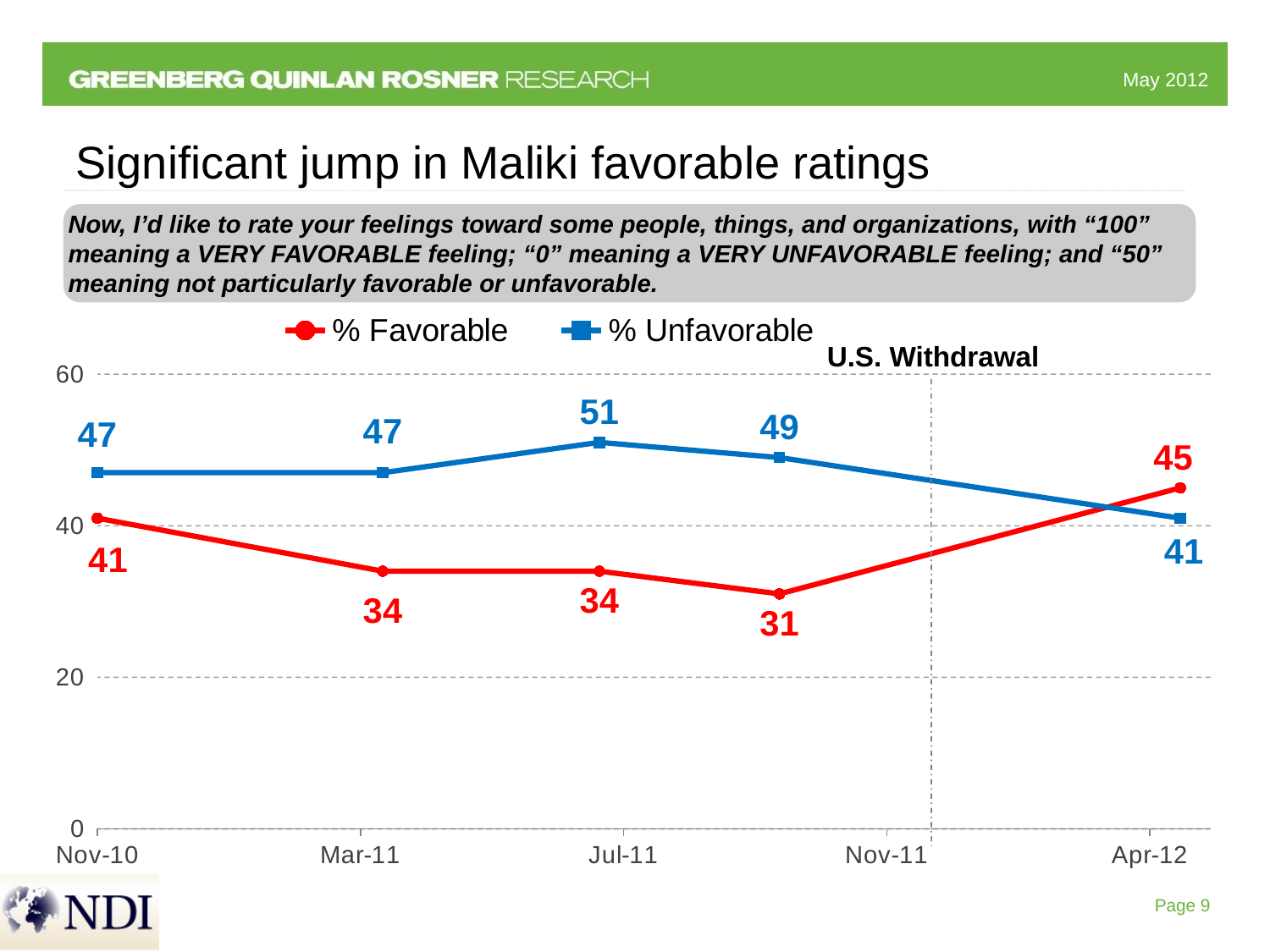
What is the % Favorable value at Mar-11? 34 What is the highest value reached by the % Unfavorable series? 51 At Apr-12, how much higher is % Favorable than % Unfavorable? 4 What is the % Unfavorable value at Jul-11? 51 What is the % Unfavorable value at Nov-10? 47 What is the lowest value reached by the % Favorable series? 31 What kind of chart is shown on the slide? line chart How many series does the legend list? 2 How many data points are plotted for each series? 5 What event does the vertical dashed line on the chart mark? U.S. Withdrawal At Mar-11, which series has the larger value, % Favorable or % Unfavorable? % Unfavorable What is the % Favorable value at Apr-12? 45